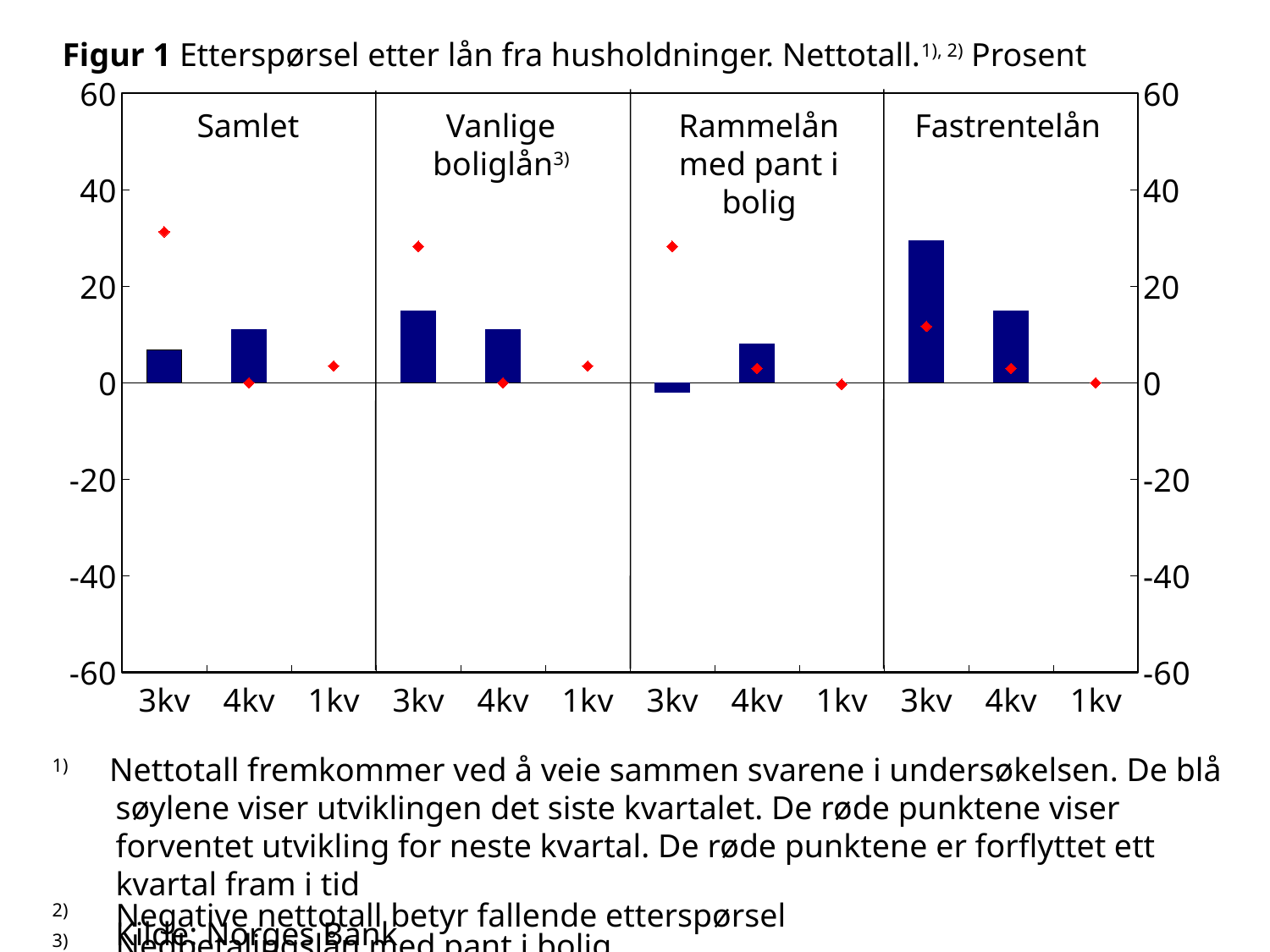
Is the 3kv blue bar for Fastrentelån greater or less than 20? greater Is the 3kv blue bar for Samlet greater or less than 20? less Is the red point for 3kv in the Samlet panel greater or less than 20? greater How many quarter labels are shown on the x axis within each panel? 3 In the Vanlige boliglån panel, which blue bar is taller, 3kv or 4kv? 3kv In the Fastrentelån panel, do the blue bars rise or fall from 3kv to 4kv? fall In the Rammelån med pant i bolig panel, do the blue bars rise or fall from 3kv to 4kv? rise Which panel contains the only blue bar that is below zero? Rammelån med pant i bolig How many panels (loan categories) does the chart have? 4 Which panel contains the tallest blue bar? Fastrentelån What is the title of the figure? Figur 1 Etterspørsel etter lån fra husholdninger. Nettotall. Prosent What kind of chart is shown on the slide? bar chart